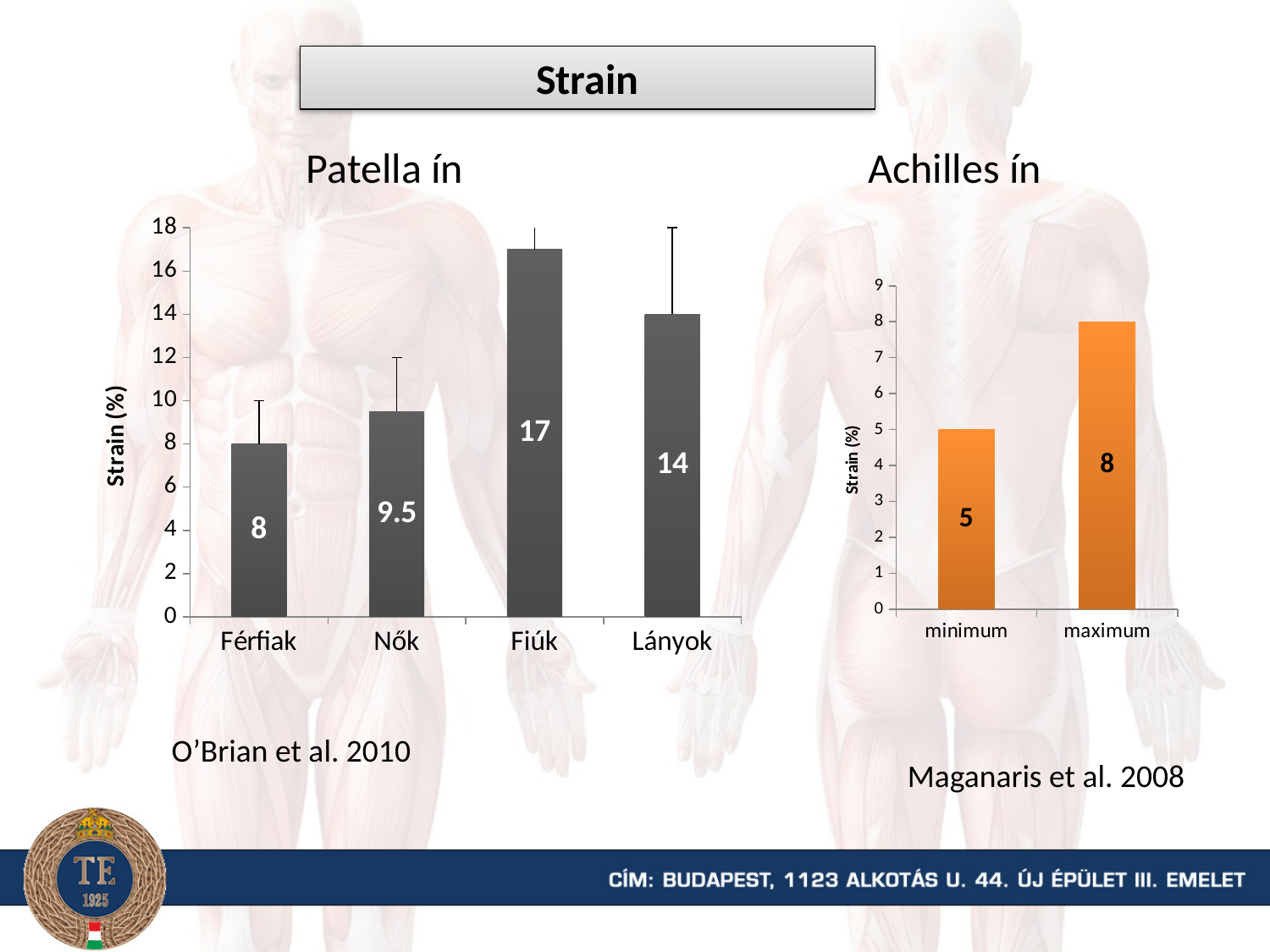
In the Patella ín chart, which category has the highest strain? Fiúk In the Patella ín chart, what is the difference between the strain values for Fiúk and Lányok? 3 In the Patella ín chart, what is the strain value for Nők? 9.5 What is the y-axis label of the Patella ín chart? Strain (%) How many categories are shown in the Patella ín chart? 4 In the Patella ín chart, what is the strain value for Fiúk? 17 In the Patella ín chart, which is larger, the strain for Nők or for Férfiak? Nők In the Achilles ín chart, what is the strain value for minimum? 5 What kind of chart is the Achilles ín chart? Bar chart In the Achilles ín chart, what is the strain value for maximum? 8 In the Patella ín chart, which category has the lowest strain? Férfiak In the Achilles ín chart, what is the difference between the maximum and minimum strain values? 3